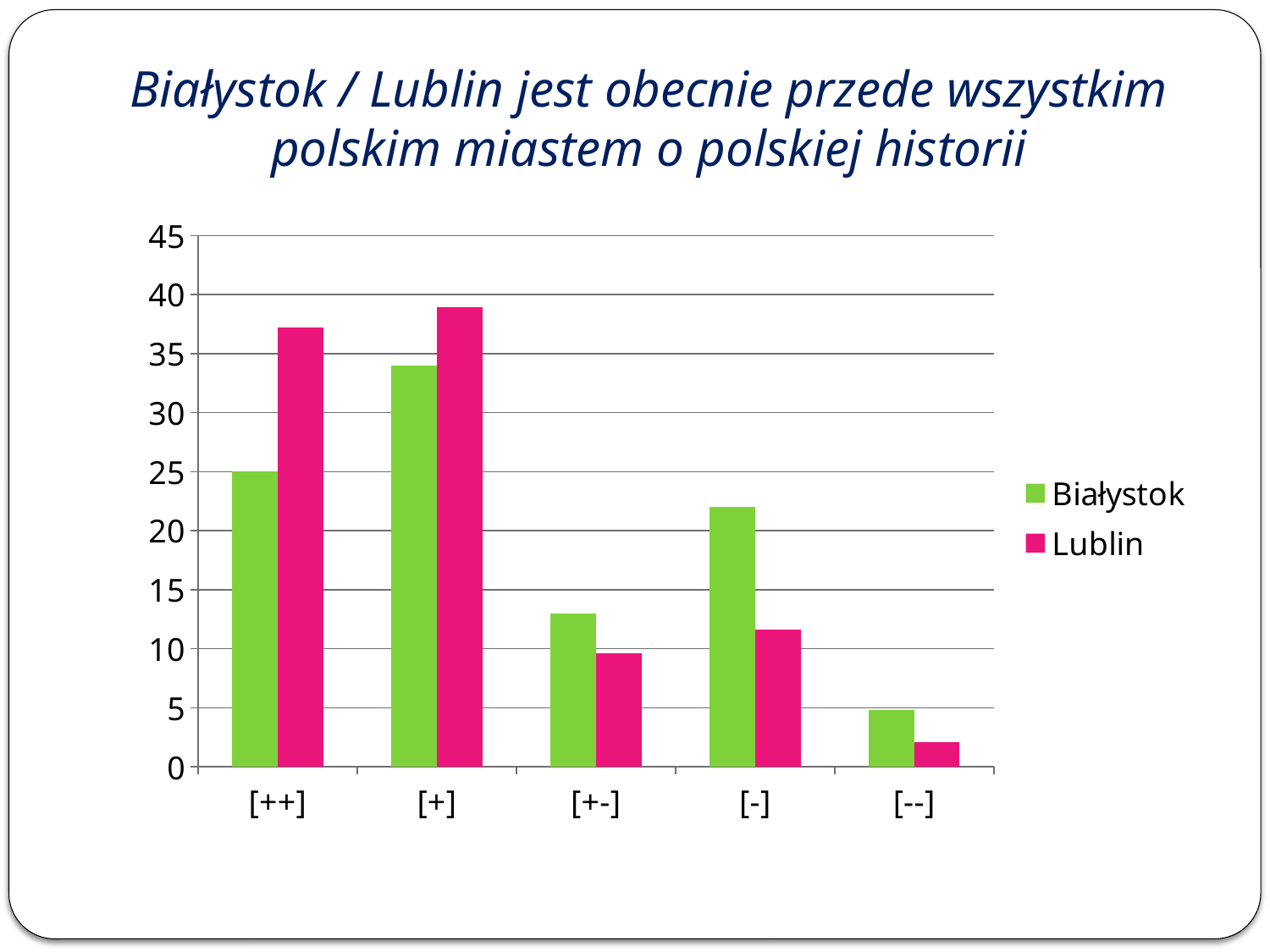
How many categories are shown on the x axis? 5 Is the value for Białystok in category [-] greater or less than 20? greater Which category has the lowest value for Białystok? [--] Which colour represents Lublin in the legend? pink Which category has the lowest value for Lublin? [--] Is the value for Lublin in category [++] greater or less than 35? greater How many series does the legend list? 2 Which category has the highest value for Lublin? [+] In category [-], which series has the larger value, Białystok or Lublin? Białystok What kind of chart is shown on the slide? bar chart Which category has the highest value for Białystok? [+]